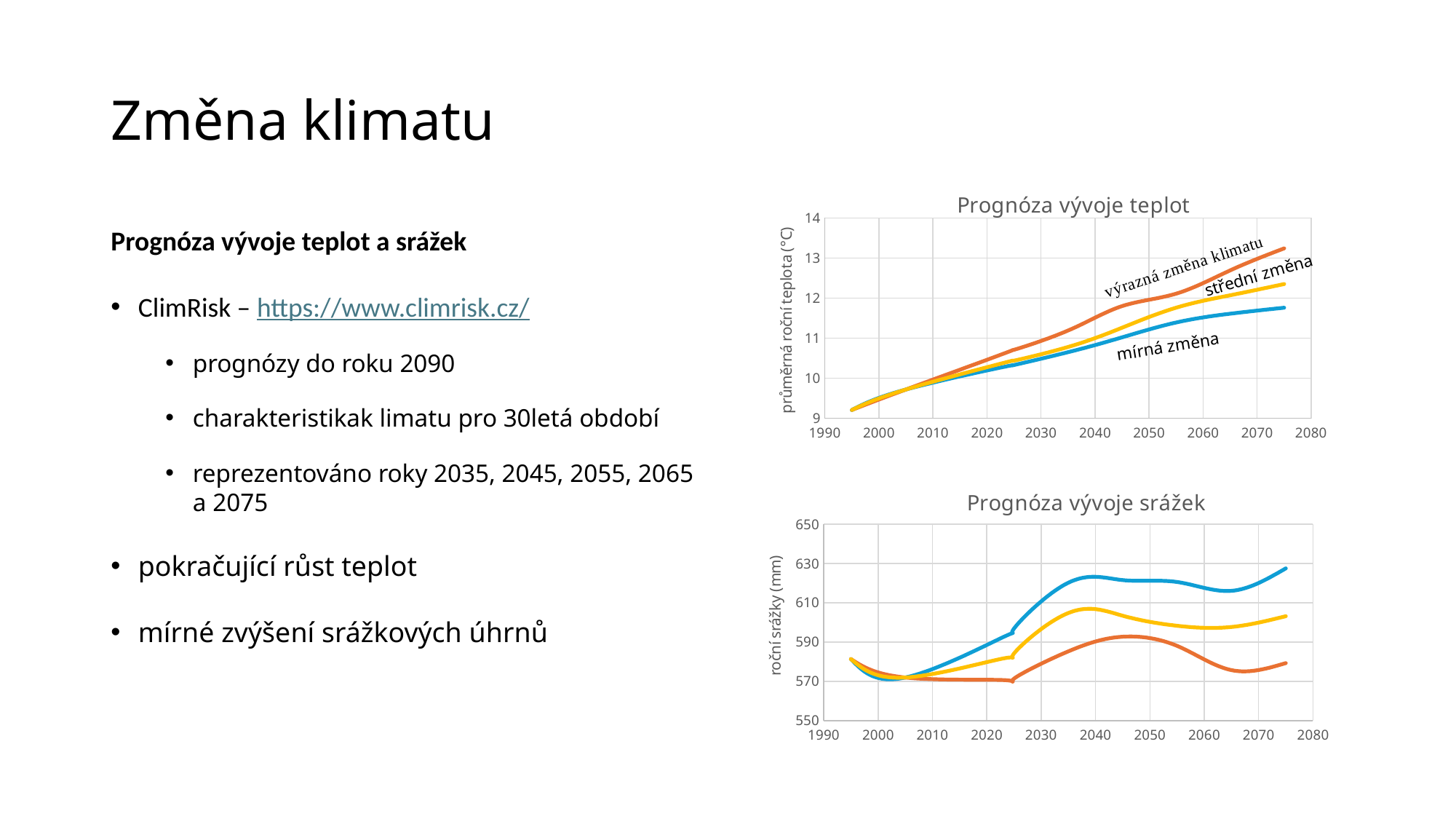
In the 'Prognóza vývoje teplot' chart, is the value for 'výrazná změna klimatu' at 2075 greater or less than 13? greater In the 'Prognóza vývoje srážek' chart, is the value of the orange line at 2075 greater or less than 590? less In the 'Prognóza vývoje teplot' chart, which scenario has the highest temperature at 2075? výrazná změna klimatu In the 'Prognóza vývoje srážek' chart, which line is highest at 2075: the blue line or the orange line? the blue line In the 'Prognóza vývoje teplot' chart, do the temperatures rise or fall from 1995 to 2075? rise What kind of chart is the 'Prognóza vývoje teplot' chart? line chart What kind of chart is the 'Prognóza vývoje srážek' chart? line chart In the 'Prognóza vývoje teplot' chart, which scenario has the lowest temperature at 2075? mírná změna In the 'Prognóza vývoje teplot' chart, is the value for 'mírná změna' at 2075 greater or less than 12? less What is the y-axis label of the 'Prognóza vývoje teplot' chart? průměrná roční teplota (°C) In the 'Prognóza vývoje teplot' chart, how many lines (scenarios) are plotted? 3